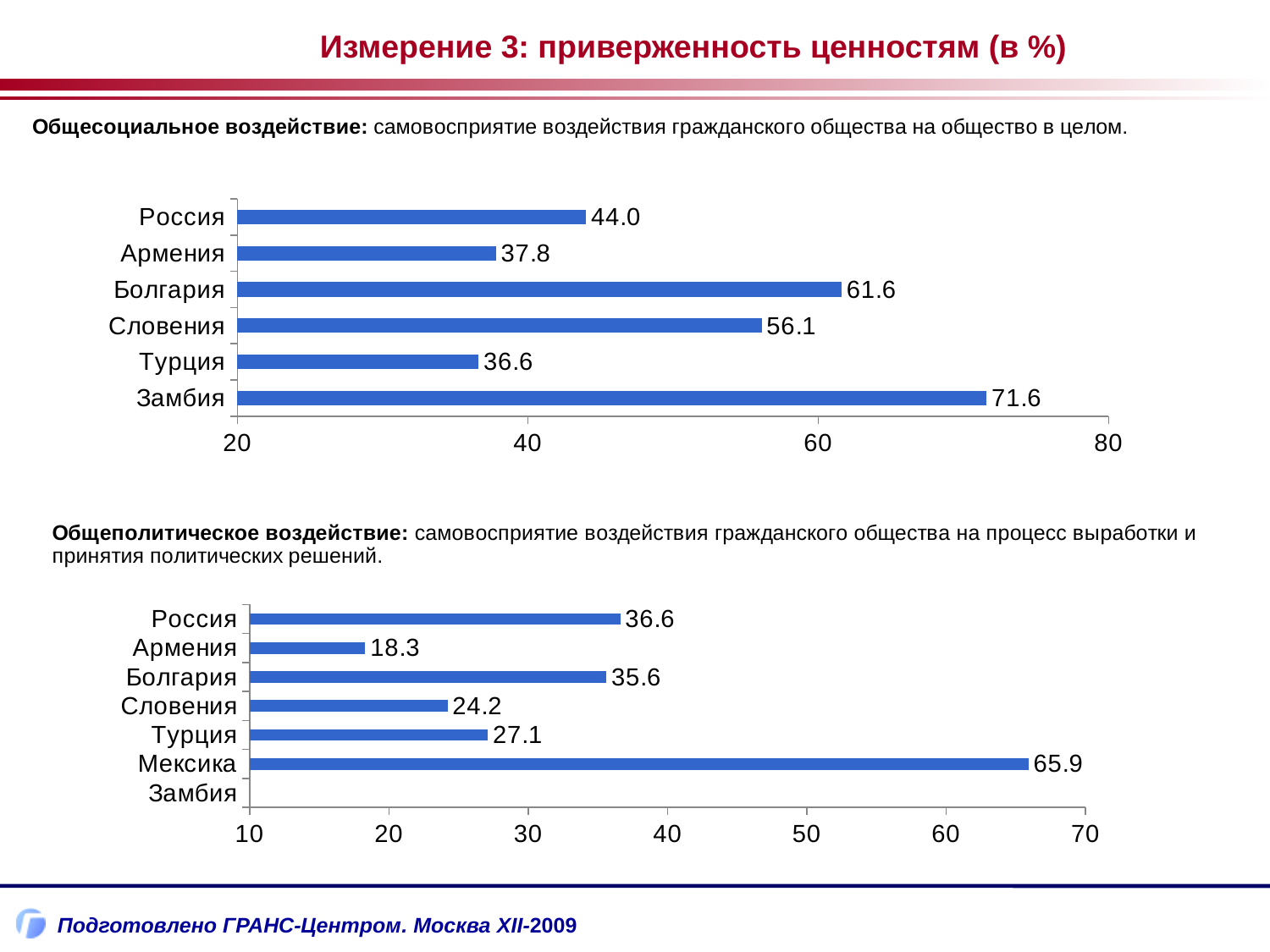
In the bottom chart (Общеполитическое воздействие), what is the value for Словения? 24.2 What type of chart is the top chart (Общесоциальное воздействие)? Bar chart In the top chart (Общесоциальное воздействие), which country has the lowest value? Турция In the top chart (Общесоциальное воздействие), what is the value for Армения? 37.8 In the bottom chart (Общеполитическое воздействие), what is the difference between Россия and Армения? 18.3 In the top chart (Общесоциальное воздействие), what is the value for Замбия? 71.6 In the top chart (Общесоциальное воздействие), how many countries are shown? 6 In the bottom chart (Общеполитическое воздействие), which has a larger value, Россия or Болгария? Россия In the bottom chart (Общеполитическое воздействие), is the value for Турция greater or less than 30? less In the top chart (Общесоциальное воздействие), which country has the highest value? Замбия In the bottom chart (Общеполитическое воздействие), what is the value for Мексика? 65.9 In the top chart (Общесоциальное воздействие), what is the difference between Болгария and Словения? 5.5